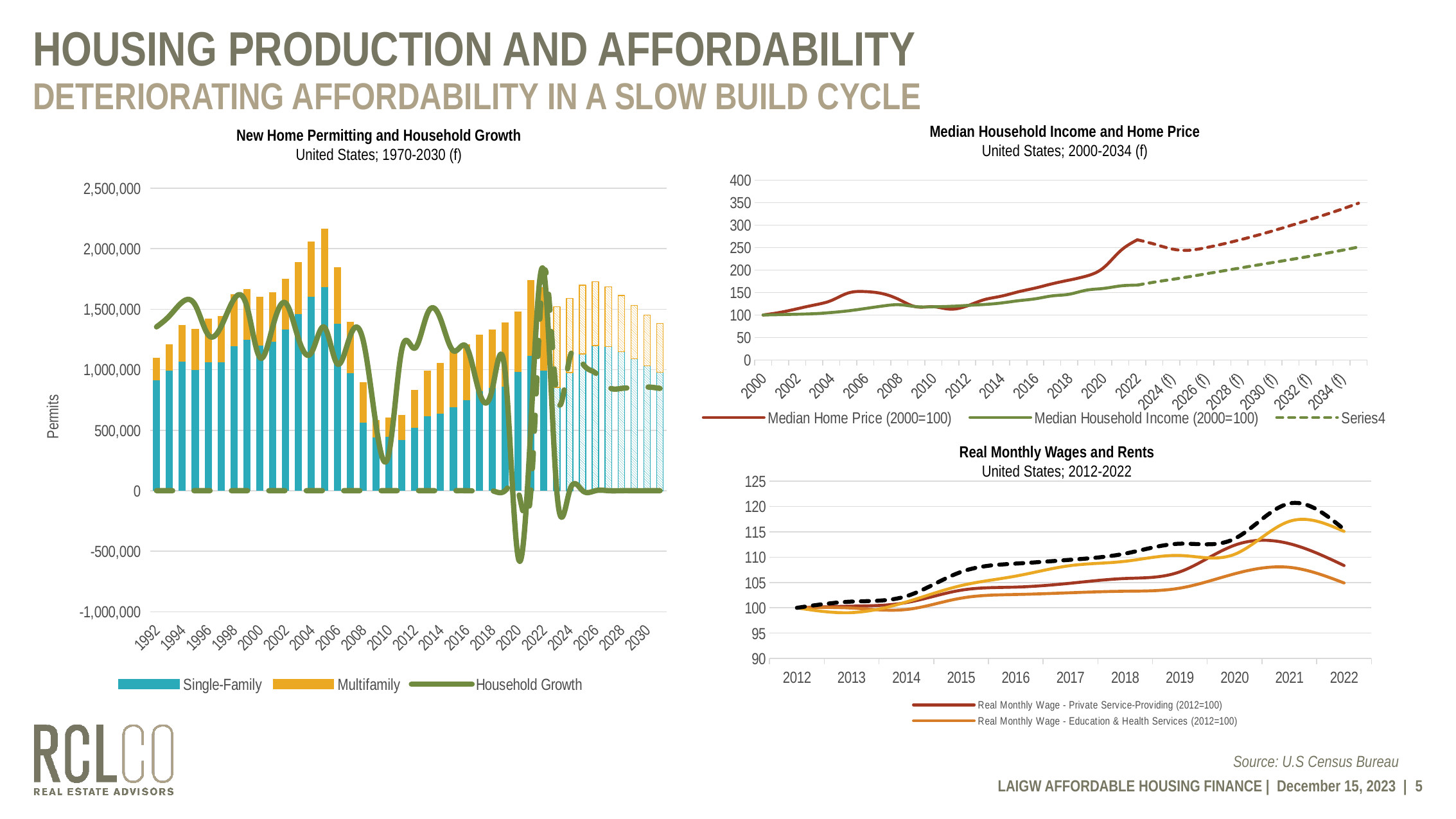
In the 'Median Household Income and Home Price' chart, what is the value of Median Home Price (2000=100) in 2000? 100 In the 'Median Household Income and Home Price' chart, is the value of Median Household Income (2000=100) in 2022 greater or less than 200? less In the 'Median Household Income and Home Price' chart, is the value of Median Home Price (2000=100) in 2022 greater or less than 250? greater In the 'New Home Permitting and Household Growth' chart, what kind of chart is used for the Single-Family and Multifamily series? bar chart How many series does the legend of the 'New Home Permitting and Household Growth' chart list? 3 What kind of chart is the 'Real Monthly Wages and Rents' chart? line chart How many years are shown on the x axis of the 'Real Monthly Wages and Rents' chart? 11 In the 'Real Monthly Wages and Rents' chart, is the value of Real Monthly Wage - Private Service-Providing in 2021 greater or less than 110? greater In the 'Real Monthly Wages and Rents' chart, does the Real Monthly Wage - Private Service-Providing series rise or fall from 2021 to 2022? fall What is the y-axis label of the 'New Home Permitting and Household Growth' chart? Permits In the 'Median Household Income and Home Price' chart, which is larger in 2022: Median Home Price or Median Household Income? Median Home Price How many entries does the legend of the 'Median Household Income and Home Price' chart list? 3